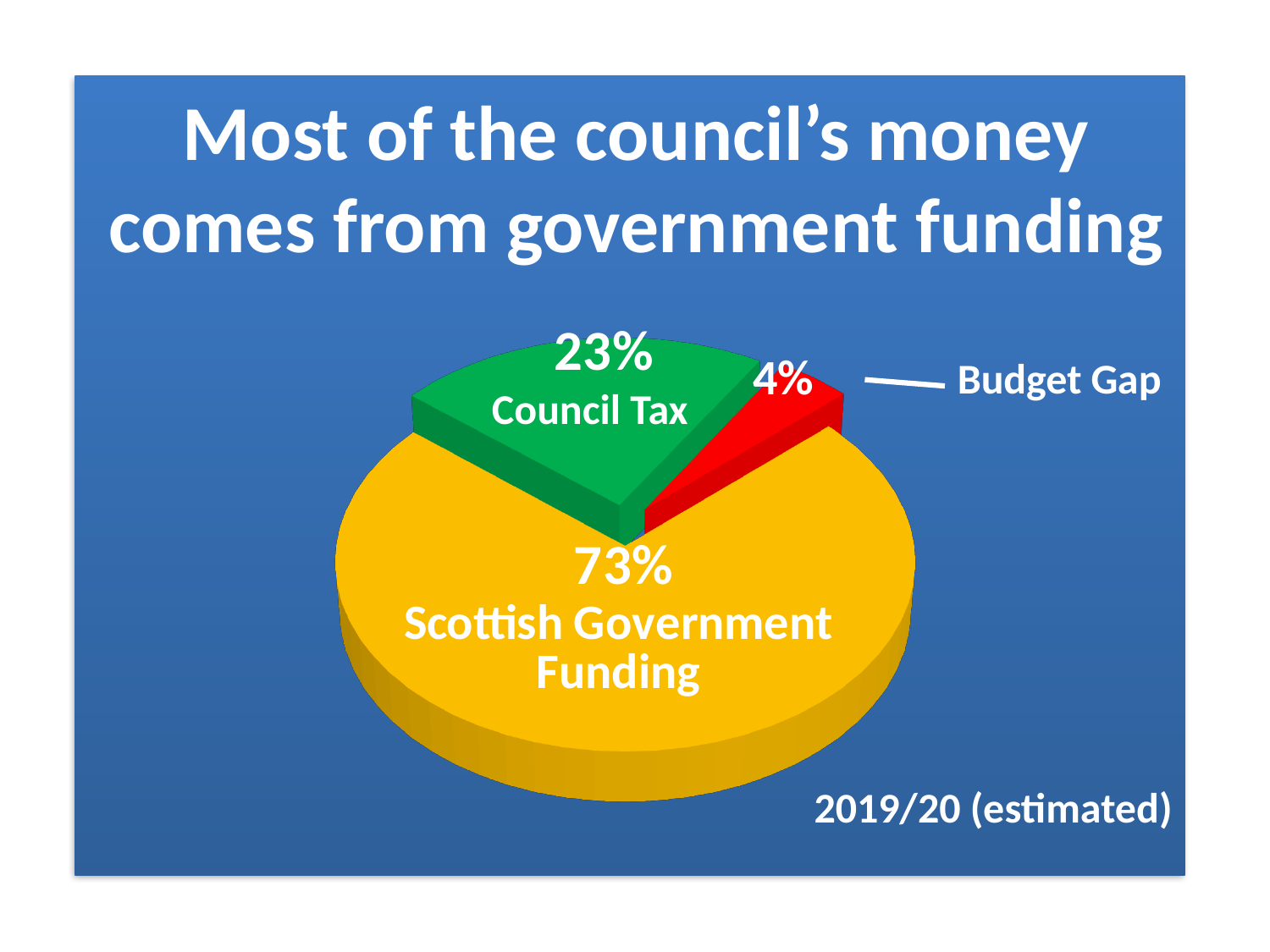
Which slice of the pie is the smallest? Budget Gap What is the difference in percentage points between Scottish Government Funding and Council Tax? 50 What colour is the Budget Gap slice? Red What kind of chart is shown on the slide? Pie chart Which year does the chart refer to? 2019/20 (estimated) What share of the pie is Scottish Government Funding? 73% Which slice of the pie is the largest? Scottish Government Funding What is the difference in percentage points between Council Tax and the Budget Gap? 19 What share of the pie is the Budget Gap? 4% What share of the pie is Council Tax? 23% Which is larger, Council Tax or the Budget Gap? Council Tax How many slices does the pie chart have? 3